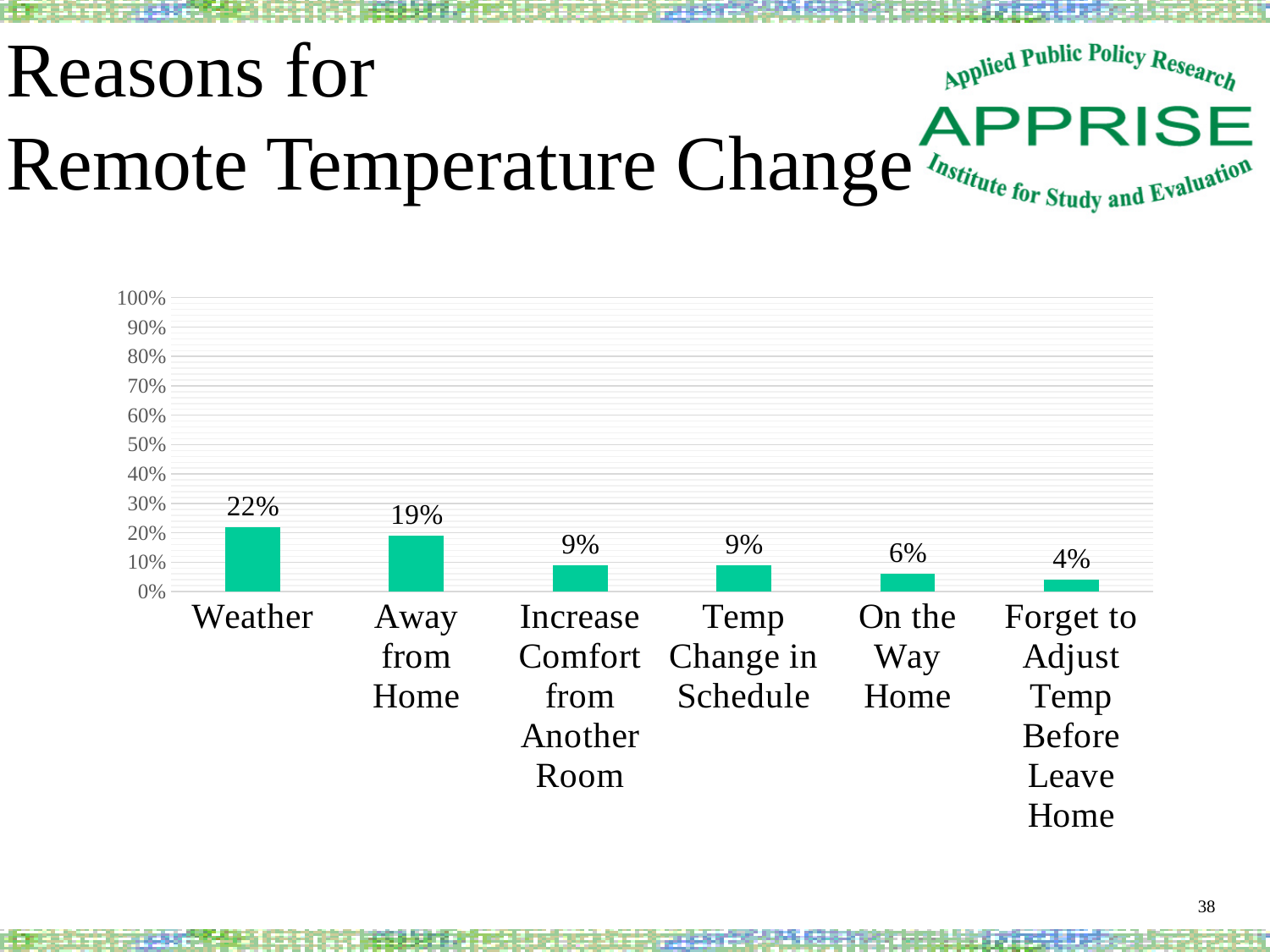
Do the values rise or fall from left to right across the categories? fall What is the difference between the values for Weather and Away from Home? 3% What percentage is shown for On the Way Home? 6% Which reason has the lowest percentage? Forget to Adjust Temp Before Leave Home What kind of chart is shown on the slide? bar chart What percentage is shown for Weather? 22% Is the value for Weather greater or less than 30%? less What is the value for Away from Home? 19% Which reason has the highest percentage? Weather How many reasons are shown on the chart? 6 What is the value for Forget to Adjust Temp Before Leave Home? 4% Which is larger, the value for Away from Home or the value for On the Way Home? Away from Home